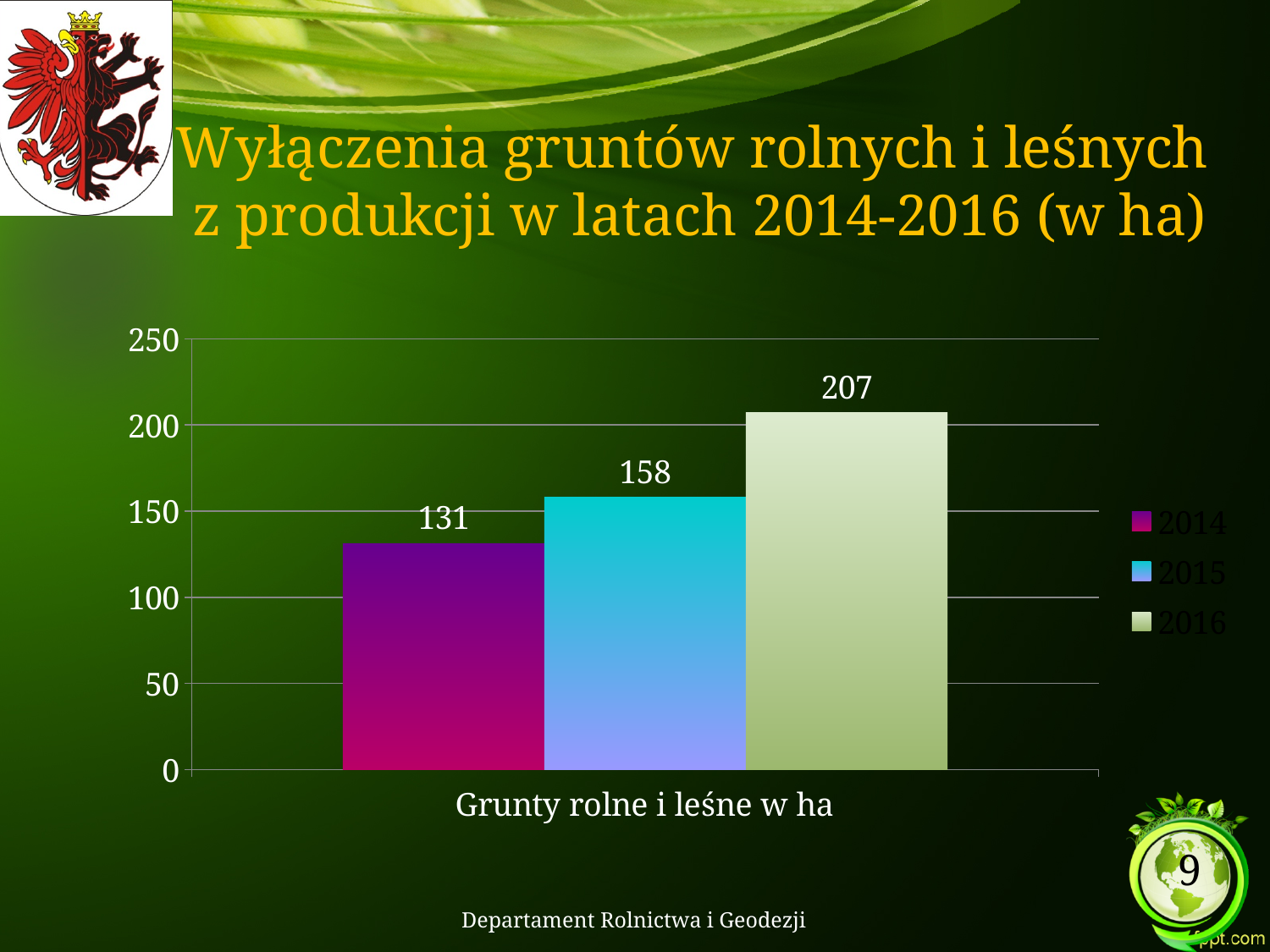
Is the value for 2016 greater or less than 200? greater What is the difference between the values for 2016 and 2014? 76 What is the value for 2014? 131 What is the label on the x axis of the chart? Grunty rolne i leśne w ha What is the difference between the values for 2015 and 2014? 27 What is the value for 2016? 207 Which year has the lowest value? 2014 How many series does the legend list? 3 What kind of chart is shown on the slide? bar chart Which year has the highest value? 2016 Which is larger, the value for 2015 or the value for 2016? 2016 What is the value for 2015? 158